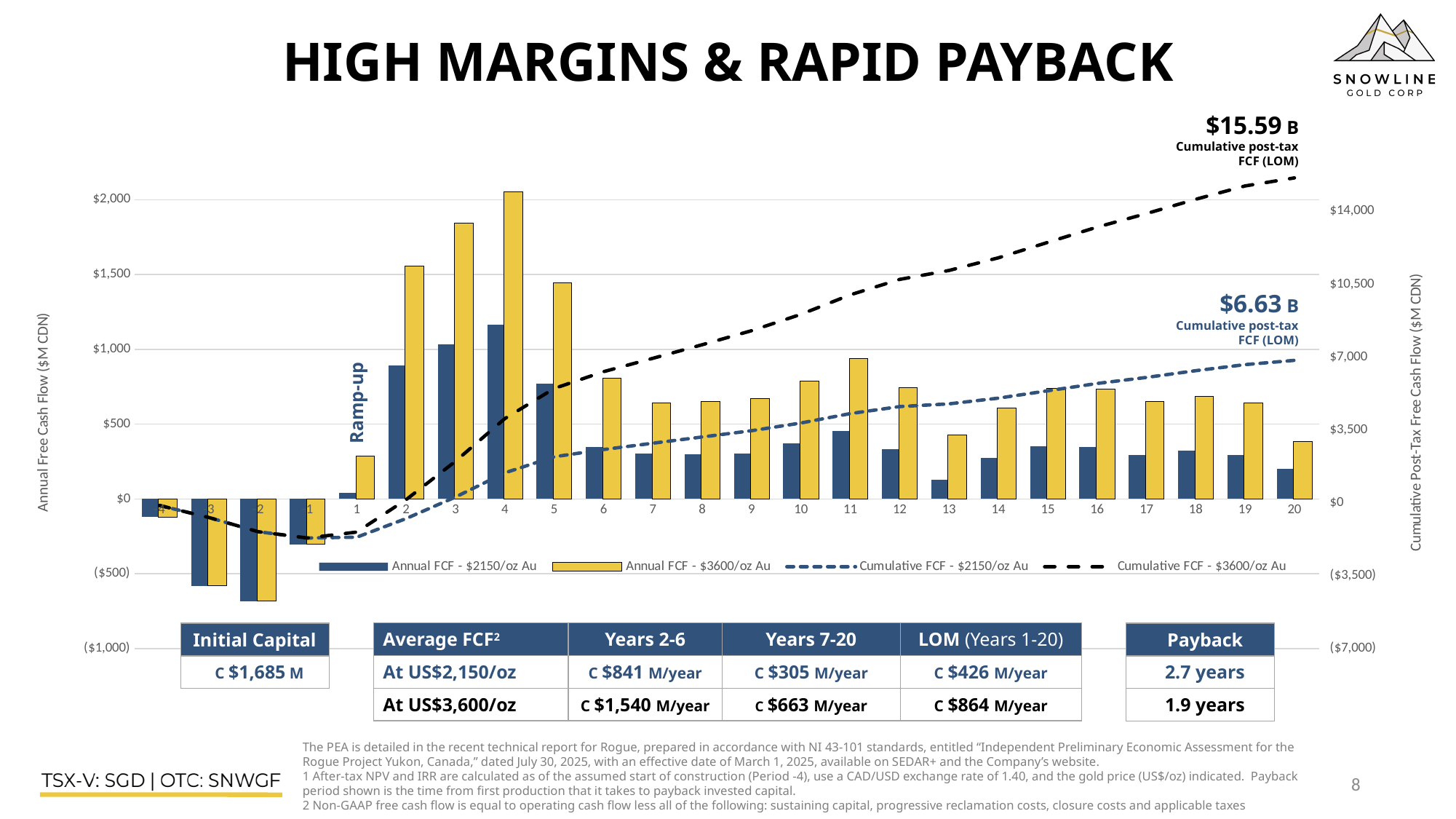
Is the Annual FCF - $2150/oz Au value for year 6 greater or less than $500? less Do the cumulative FCF lines rise or fall across production years 1 to 20? rise What kind of chart is shown on the slide? A combination bar and line chart How many series does the chart legend list? 4 In which production year is the Annual FCF - $3600/oz Au bar the highest? Year 4 What is the difference between the cumulative post-tax FCF (LOM) at $3600/oz Au and at $2150/oz Au? $8.96 B Is the Annual FCF - $3600/oz Au value for year 4 greater or less than $2,000? greater Which cumulative FCF line ends higher, the $2150/oz Au line or the $3600/oz Au line? $3600/oz Au In which production year is the Annual FCF - $2150/oz Au bar the highest? Year 4 What colour are the Annual FCF - $3600/oz Au bars? Yellow What is the cumulative post-tax FCF (LOM) at $3600/oz Au shown on the chart? $15.59 B What is the cumulative post-tax FCF (LOM) at $2150/oz Au shown on the chart? $6.63 B